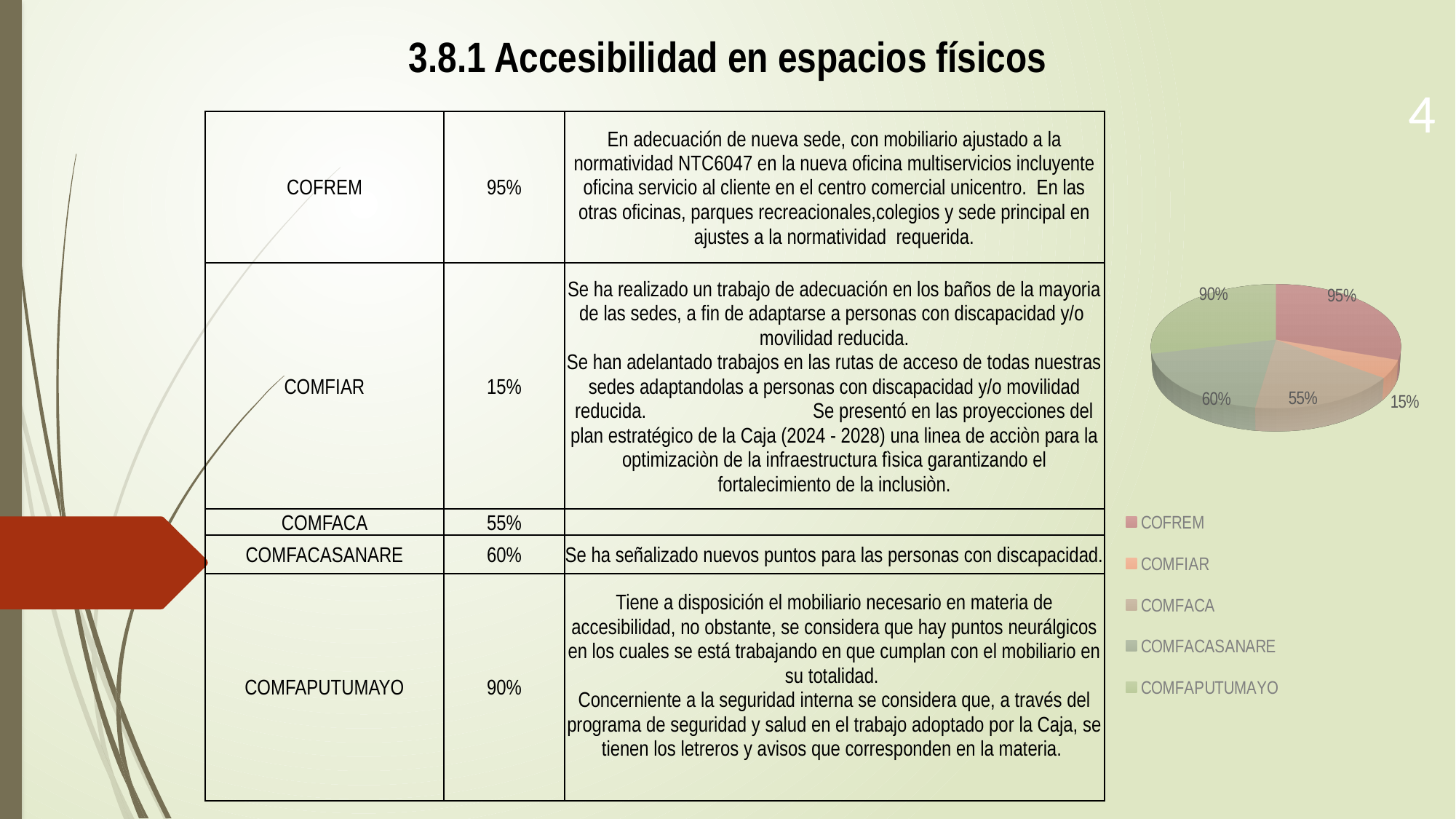
In the pie chart, what value is labelled for COFREM? 95% What kind of chart is shown on the right side of the slide? pie chart In the pie chart, what value is labelled for COMFACASANARE? 60% In the pie chart, what value is labelled for COMFIAR? 15% How many slices does the pie chart have? 5 Which category has the largest slice in the pie chart? COFREM What is the difference between the values labelled for COMFAPUTUMAYO and COMFACA in the pie chart? 35% In the pie chart, what value is labelled for COMFAPUTUMAYO? 90% Which category has the smallest slice in the pie chart? COMFIAR What is the difference between the values labelled for COFREM and COMFIAR in the pie chart? 80% How many entries does the pie chart's legend list? 5 In the pie chart, which is larger, the value for COMFACASANARE or the value for COMFACA? COMFACASANARE